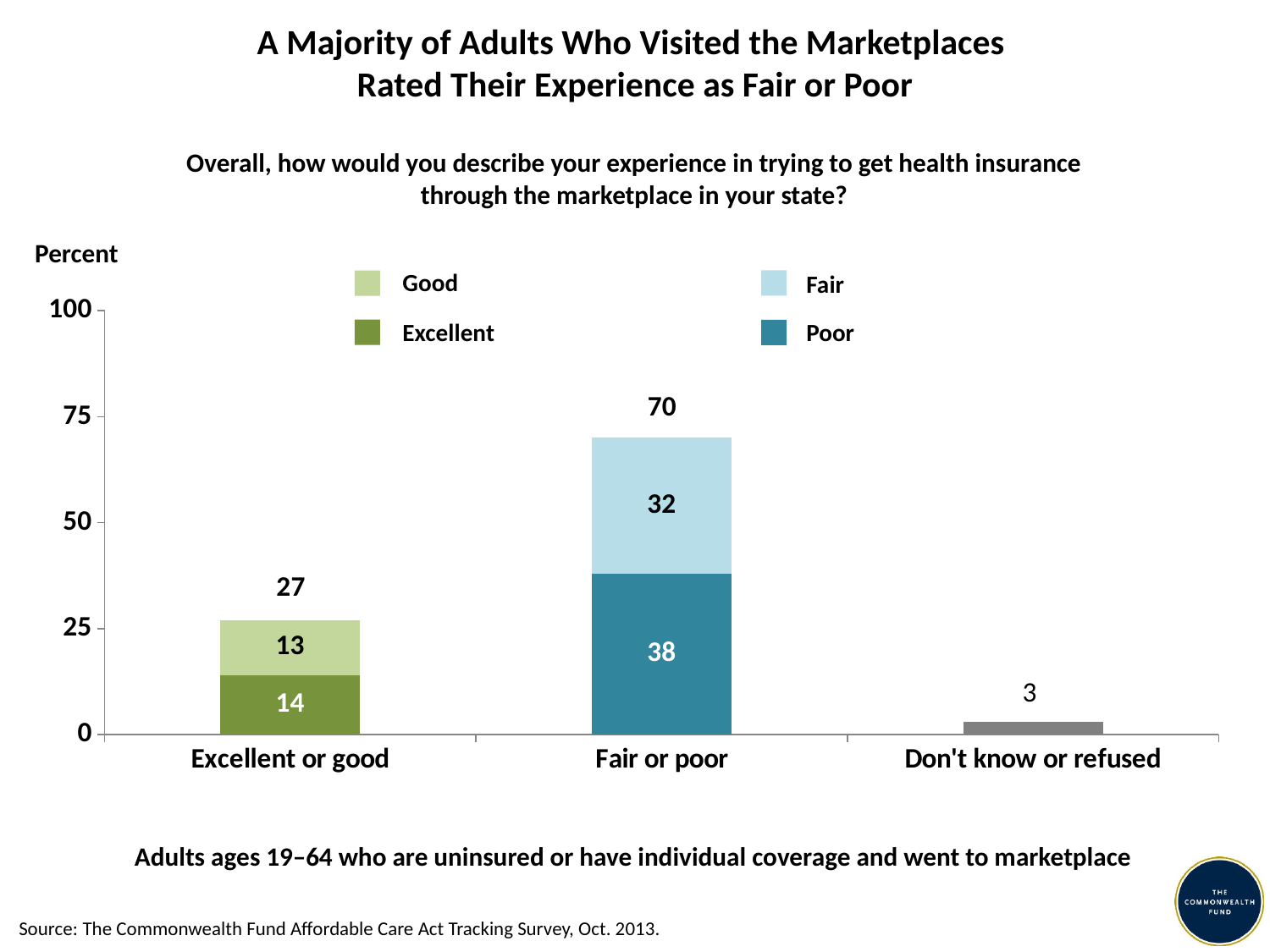
What is the total of the Fair or poor stacked bar? 70 Which category has the lowest value? Don't know or refused What is the total of the Excellent or good stacked bar? 27 What is the value of the Excellent segment in the Excellent or good bar? 14 What is the value of the Poor segment in the Fair or poor bar? 38 How many series does the legend list? 4 Which category has the highest total value? Fair or poor What is the value of the Good segment in the Excellent or good bar? 13 What is the value for Don't know or refused? 3 What is the value of the Fair segment in the Fair or poor bar? 32 Which is larger, the Poor segment or the Fair segment? Poor What is the difference between the Fair or poor total and the Excellent or good total? 43